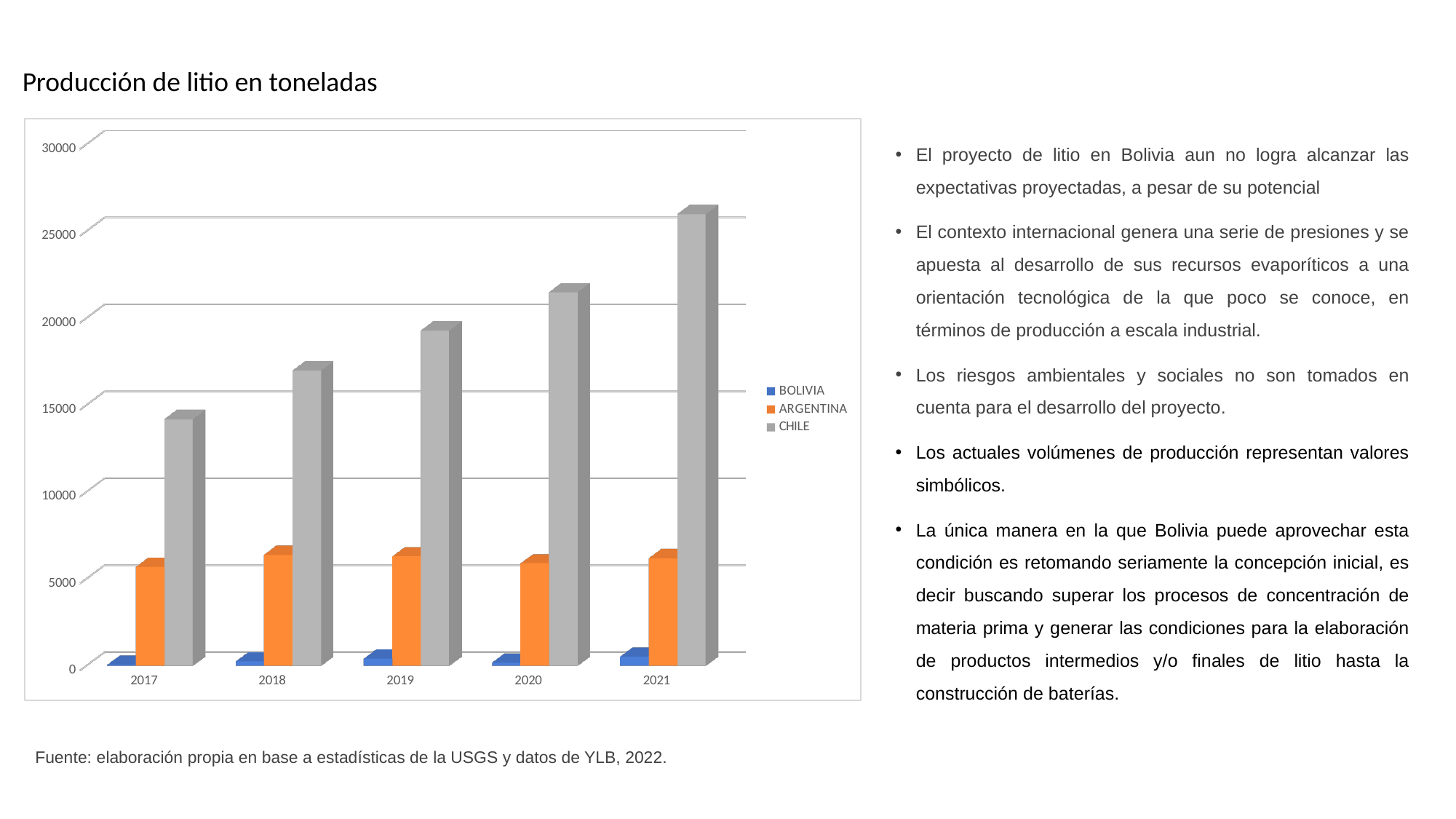
Is the value for CHILE in 2017 greater or less than 15000? less Is the value for ARGENTINA in 2021 greater or less than 10000? less How many years are shown on the x axis? 5 Does Chile's production rise or fall from 2017 to 2021? rise What is the title of the chart? Producción de litio en toneladas In 2019, which is larger: the value for CHILE or the value for ARGENTINA? CHILE How many series does the legend list? 3 Which country has the highest lithium production in every year shown? CHILE Is the value for CHILE in 2021 greater or less than 25000? greater Which country has the lowest lithium production in every year shown? BOLIVIA What kind of chart is shown on the slide? bar chart In which year is Chile's production highest? 2021